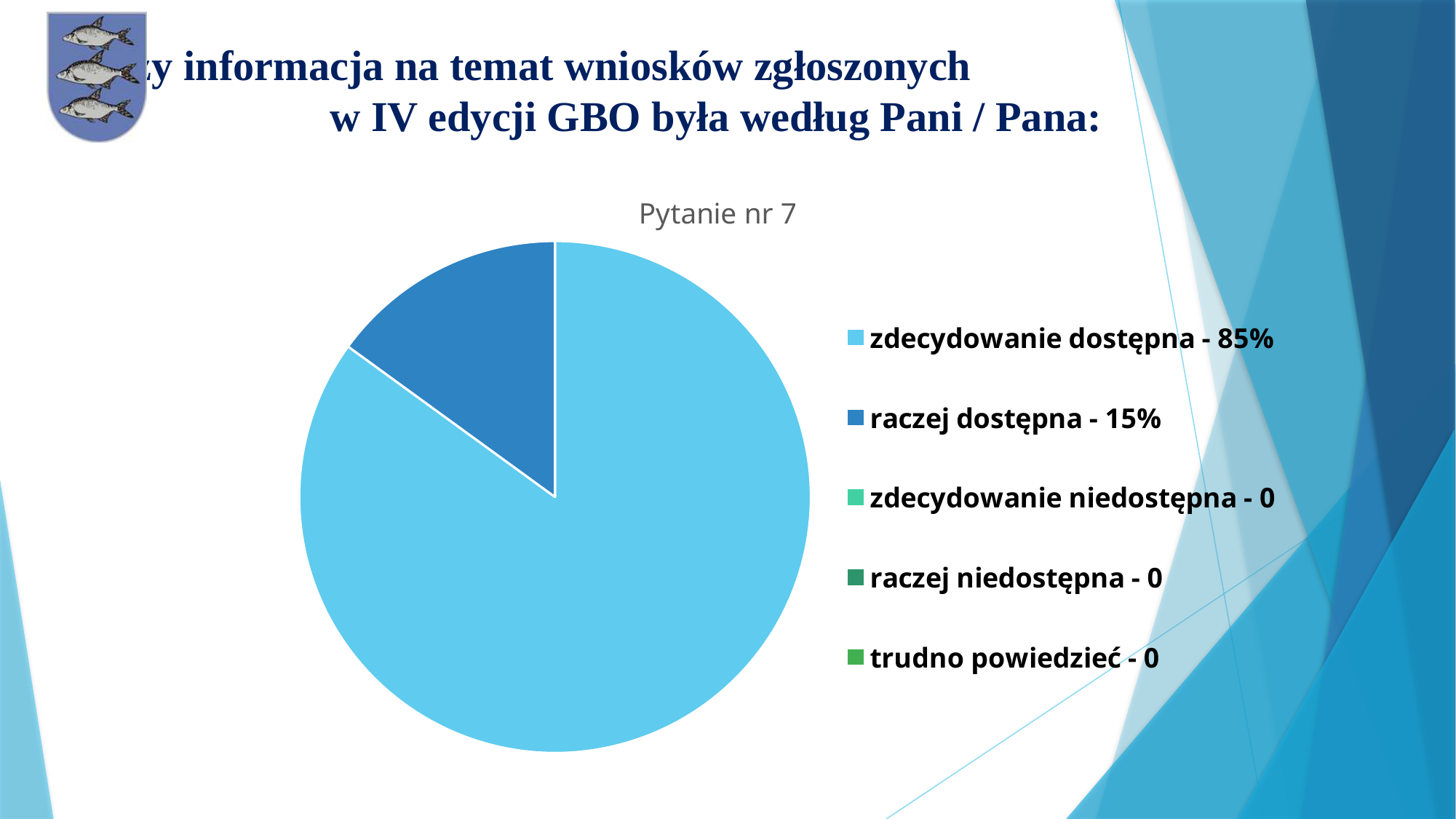
What share is shown for "raczej dostępna"? 15% How many legend categories have a value of 0? 3 What is the combined share of "zdecydowanie dostępna" and "raczej dostępna"? 100% What is the title of the chart? Pytanie nr 7 Which is larger, the share for "zdecydowanie dostępna" or for "raczej dostępna"? zdecydowanie dostępna Which category has the largest share of the pie? zdecydowanie dostępna What share is shown for "zdecydowanie dostępna"? 85% What kind of chart is shown on the slide? pie chart What value is shown for "trudno powiedzieć"? 0 What is the difference in percentage points between "zdecydowanie dostępna" and "raczej dostępna"? 70 What value is shown for "raczej niedostępna"? 0 How many categories does the legend list? 5